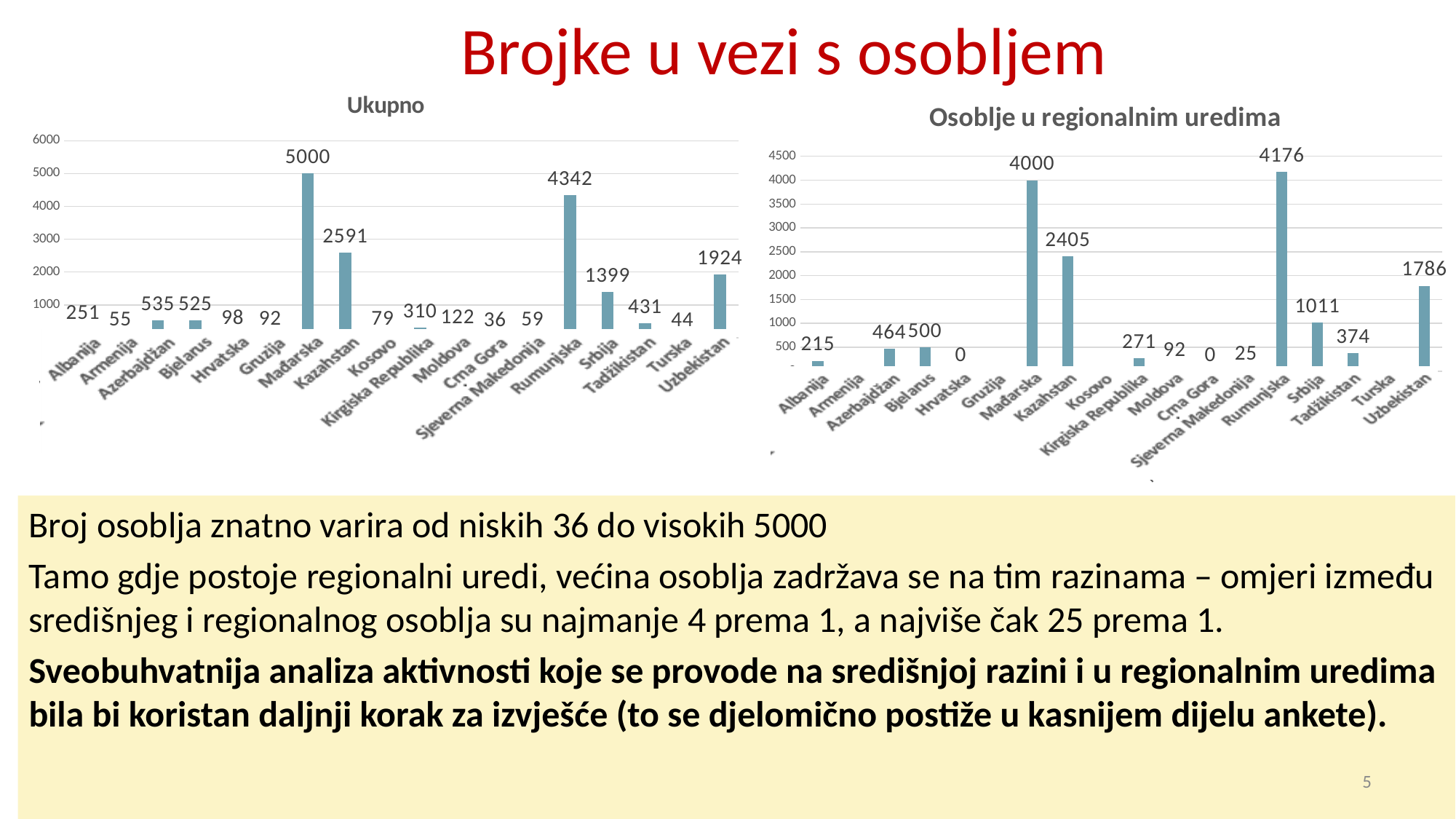
In the chart titled "Ukupno", how many categories are shown on the x axis? 18 What kind of chart is the chart titled "Ukupno"? Bar chart In the chart titled "Ukupno", what is the value for Mađarska? 5000 In the chart titled "Ukupno", what is the value for Rumunjska? 4342 What is the title of the chart on the right side of the slide? Osoblje u regionalnim uredima In the chart titled "Ukupno", what is the difference between the values for Mađarska and Kazahstan? 2409 In the chart titled "Osoblje u regionalnim uredima", which category has the highest value? Rumunjska In the chart titled "Osoblje u regionalnim uredima", what is the value for Srbija? 1011 In the chart titled "Osoblje u regionalnim uredima", which is larger, the value for Azerbajdžan or the value for Bjelarus? Bjelarus In the chart titled "Osoblje u regionalnim uredima", what is the difference between the values for Mađarska and Kazahstan? 1595 In the chart titled "Osoblje u regionalnim uredima", what is the value for Rumunjska? 4176 In the chart titled "Ukupno", which category has the lowest value? Crna Gora